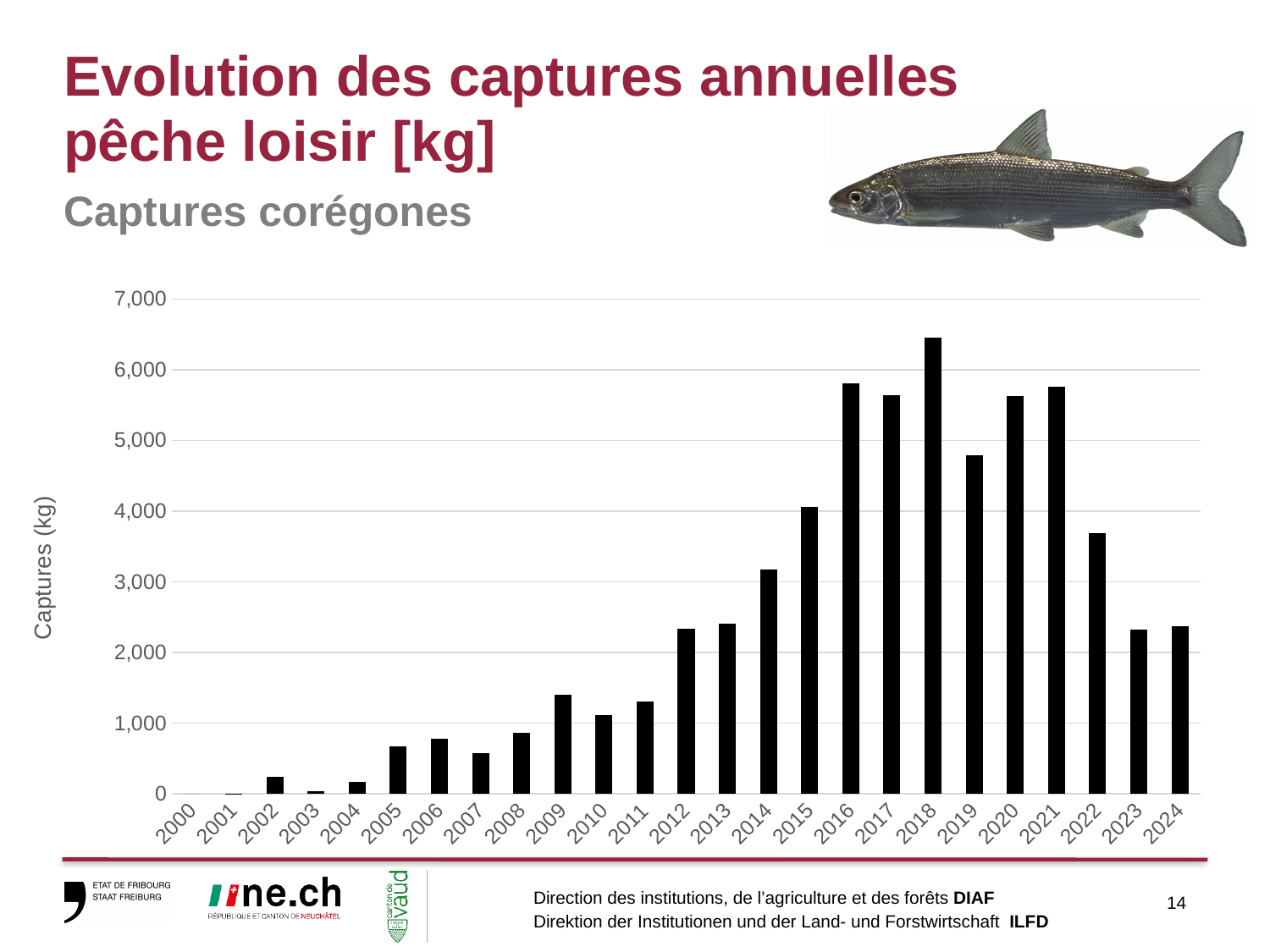
Which year has the larger value, 2022 or 2023? 2022 Which year has the larger value, 2018 or 2016? 2018 Is the value for 2018 greater or less than 6,000? greater Is the value for 2009 greater or less than 1,000? greater Do the values generally rise or fall from 2018 to 2023? fall What kind of chart is shown on the slide? bar chart Is the value for 2005 greater or less than 1,000? less What is the label on the vertical axis of the chart? Captures (kg) How many years are shown on the x axis of the chart? 25 Which year has the highest catch value in the chart? 2018